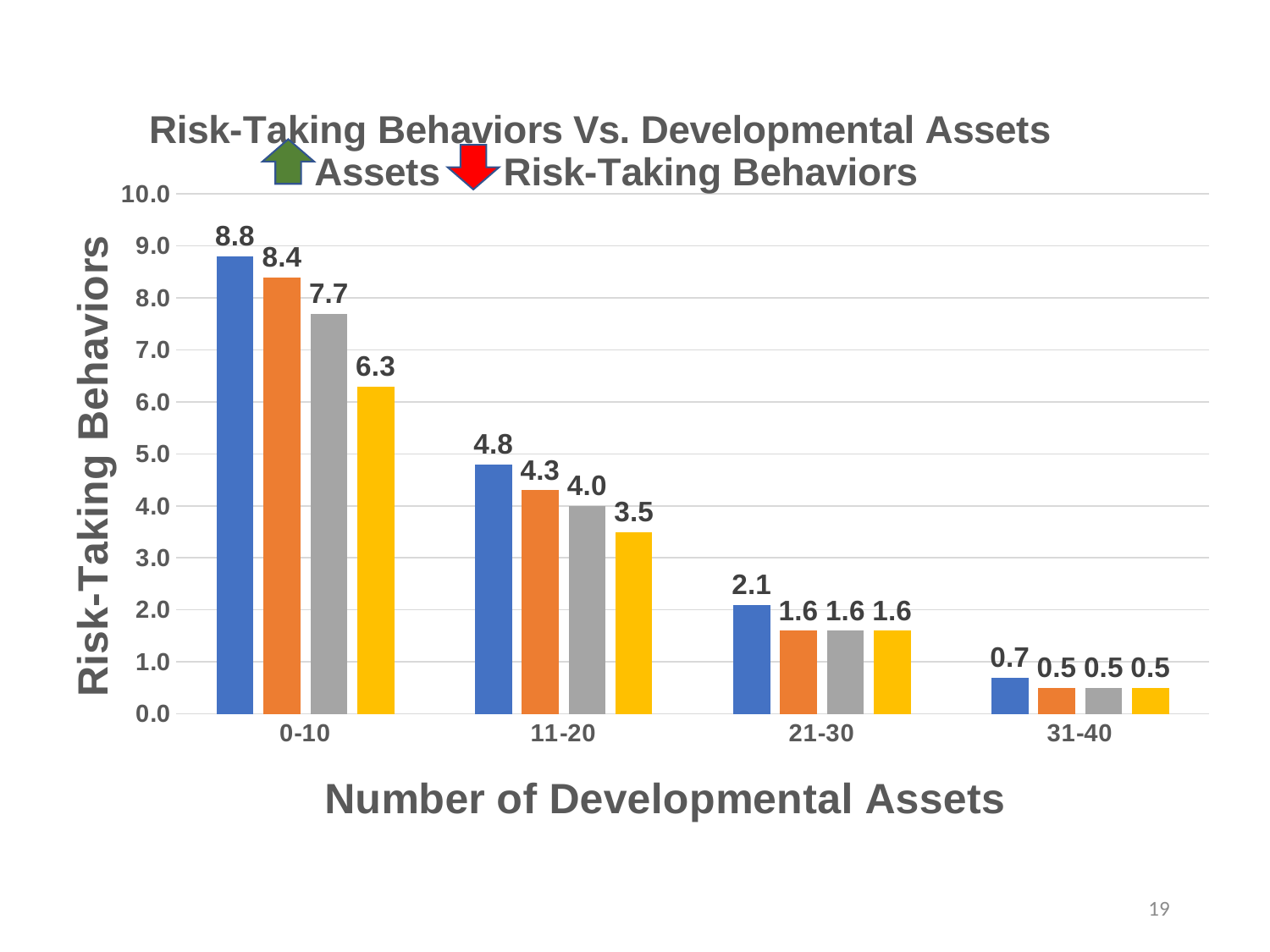
What is the difference between the blue bar and the yellow bar in the 0-10 category? 2.5 What is the value of the blue bar for the 0-10 category? 8.8 Which category has the highest blue bar? 0-10 What is the value of the gray bar for the 0-10 category? 7.7 How many categories are shown on the x axis? 4 Which is larger, the blue bar for 11-20 or the orange bar for 11-20? the blue bar for 11-20 What is the value of the yellow bar for the 11-20 category? 3.5 What is the title of the chart? Risk-Taking Behaviors Vs. Developmental Assets What type of chart is shown on the slide? bar chart Do the blue bar values rise or fall as the number of developmental assets increases along the x axis? fall What is the value of the blue bar for the 31-40 category? 0.7 Which category has the lowest orange bar? 31-40